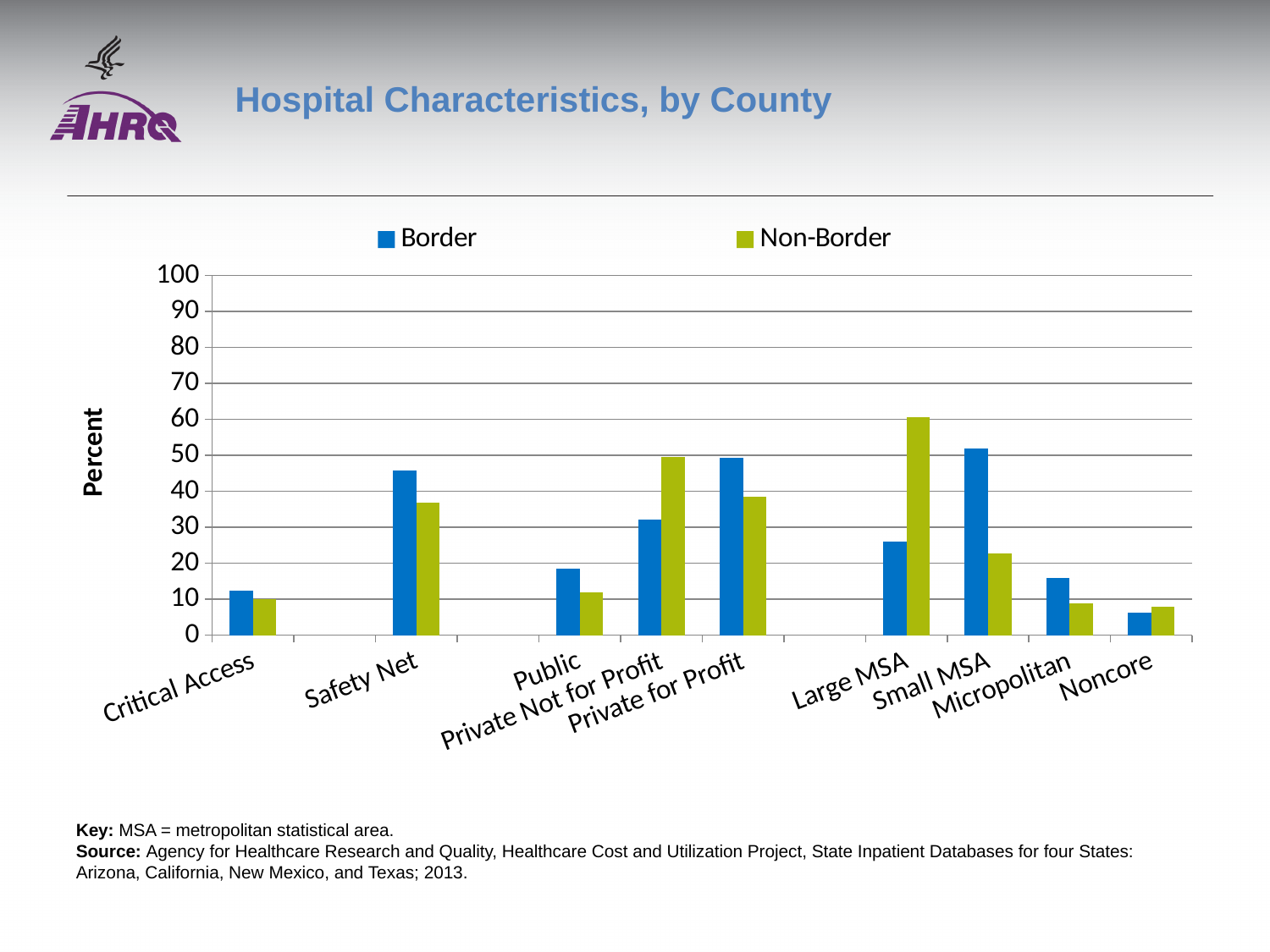
Is the Border value for Safety Net greater or less than 40? greater Is the Non-Border value for Small MSA greater or less than 30? less For Private Not for Profit, which is larger: the Border or the Non-Border value? Non-Border How many series does the legend list? 2 Which category has the lowest Border value? Noncore Which category has the highest Non-Border value? Large MSA What kind of chart is shown on the slide? bar chart For Safety Net, which is larger: the Border or the Non-Border value? Border Is the Non-Border value for Large MSA greater or less than 50? greater What is the label on the y axis? Percent How many hospital characteristic categories are shown on the x axis? 9